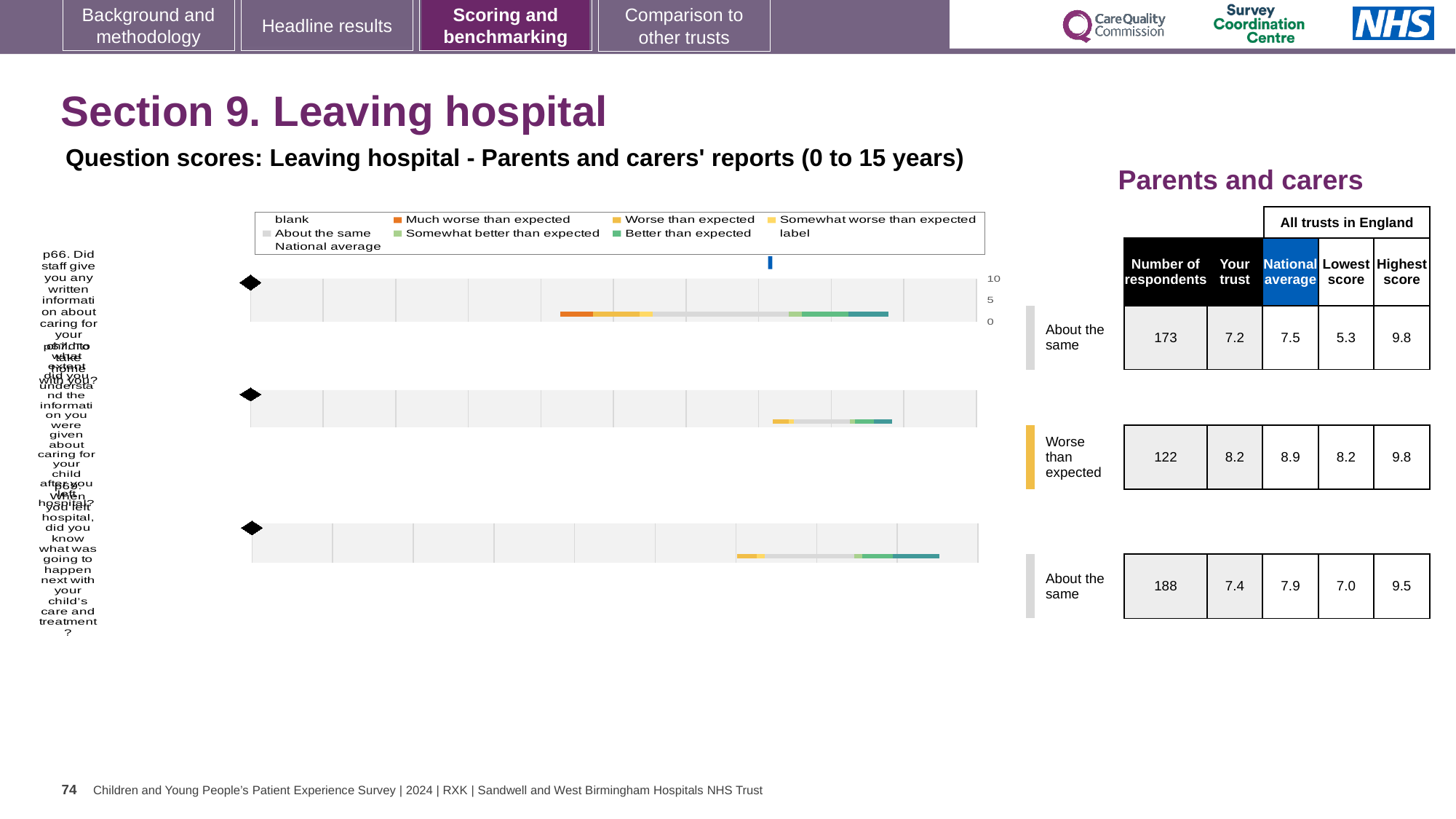
For the bottom question bar, what is the national average score? 7.9 For the bottom question bar, what is the highest score among all trusts in England? 9.5 What colour does the legend use for 'Much worse than expected'? Orange How many question bars are plotted on the slide? 3 For the middle question bar, what is the 'Your trust' score? 8.2 For the bottom question bar, which is larger: the 'Your trust' score or the national average? National average What kind of chart is used to show the question scores on this slide? Bar chart Which benchmark category is the middle question bar assigned to? Worse than expected For the top question bar, what is the difference between the national average and the 'Your trust' score? 0.3 For the top question bar, how many respondents are shown in the table? 173 Which question bar (top, middle or bottom) has the highest 'Your trust' score? Middle